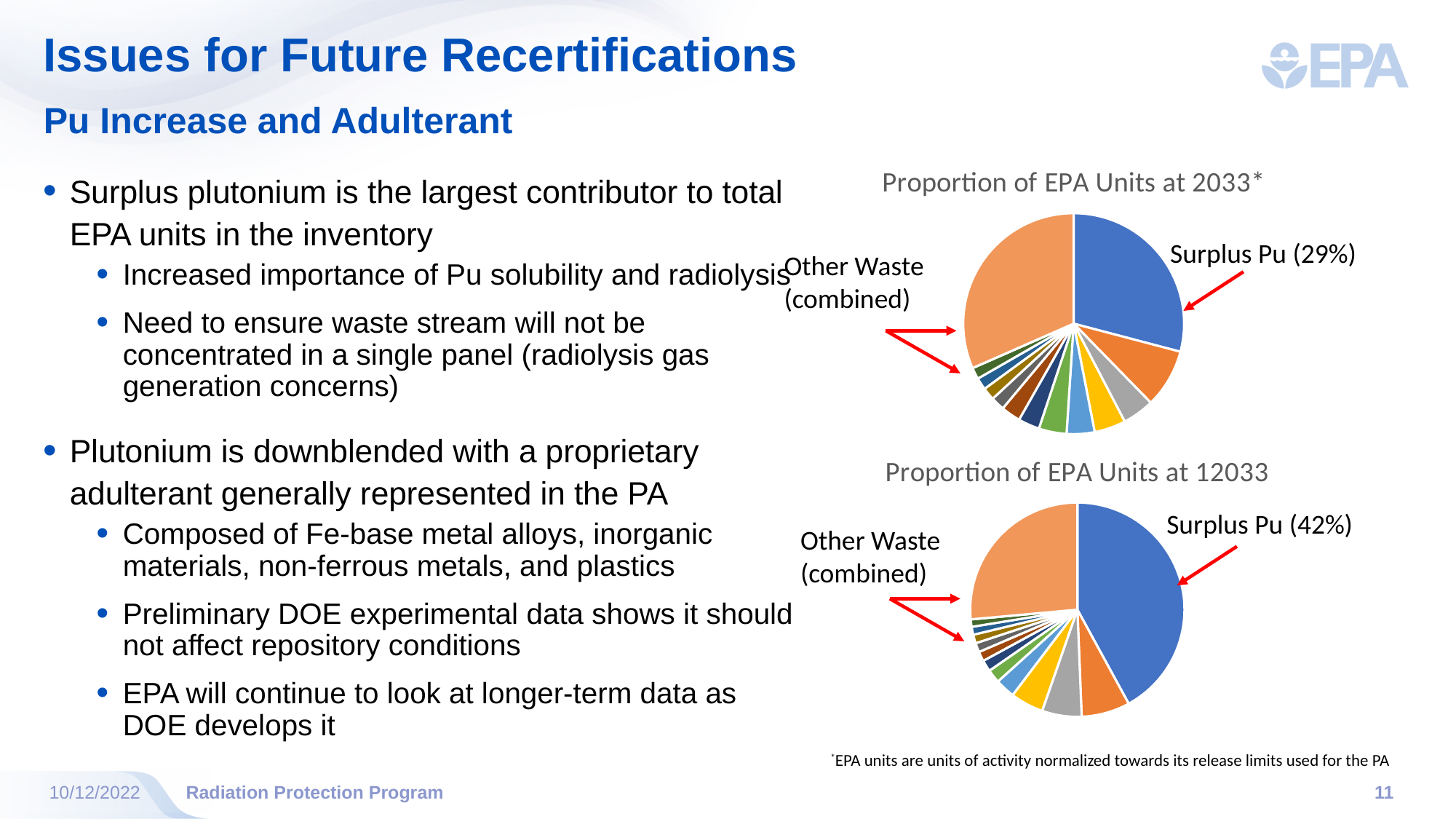
Which chart shows a larger Surplus Pu share, 'Proportion of EPA Units at 2033*' or 'Proportion of EPA Units at 12033'? Proportion of EPA Units at 12033 In the 'Proportion of EPA Units at 2033*' chart, what share of EPA units is Surplus Pu? 29% In the 'Proportion of EPA Units at 12033' chart, what label is given to the slices other than Surplus Pu? Other Waste (combined) What kind of chart is the 'Proportion of EPA Units at 12033' chart? Pie chart In the 'Proportion of EPA Units at 12033' chart, what share of EPA units is Surplus Pu? 42% How many pie charts are shown on the slide? 2 What kind of chart is the 'Proportion of EPA Units at 2033*' chart? Pie chart Does the Surplus Pu share increase or decrease from the 2033 chart to the 12033 chart? Increase By how many percentage points does the Surplus Pu share in the 'Proportion of EPA Units at 12033' chart exceed the Surplus Pu share in the 'Proportion of EPA Units at 2033*' chart? 13 percentage points What is the title of the upper pie chart on the slide? Proportion of EPA Units at 2033*